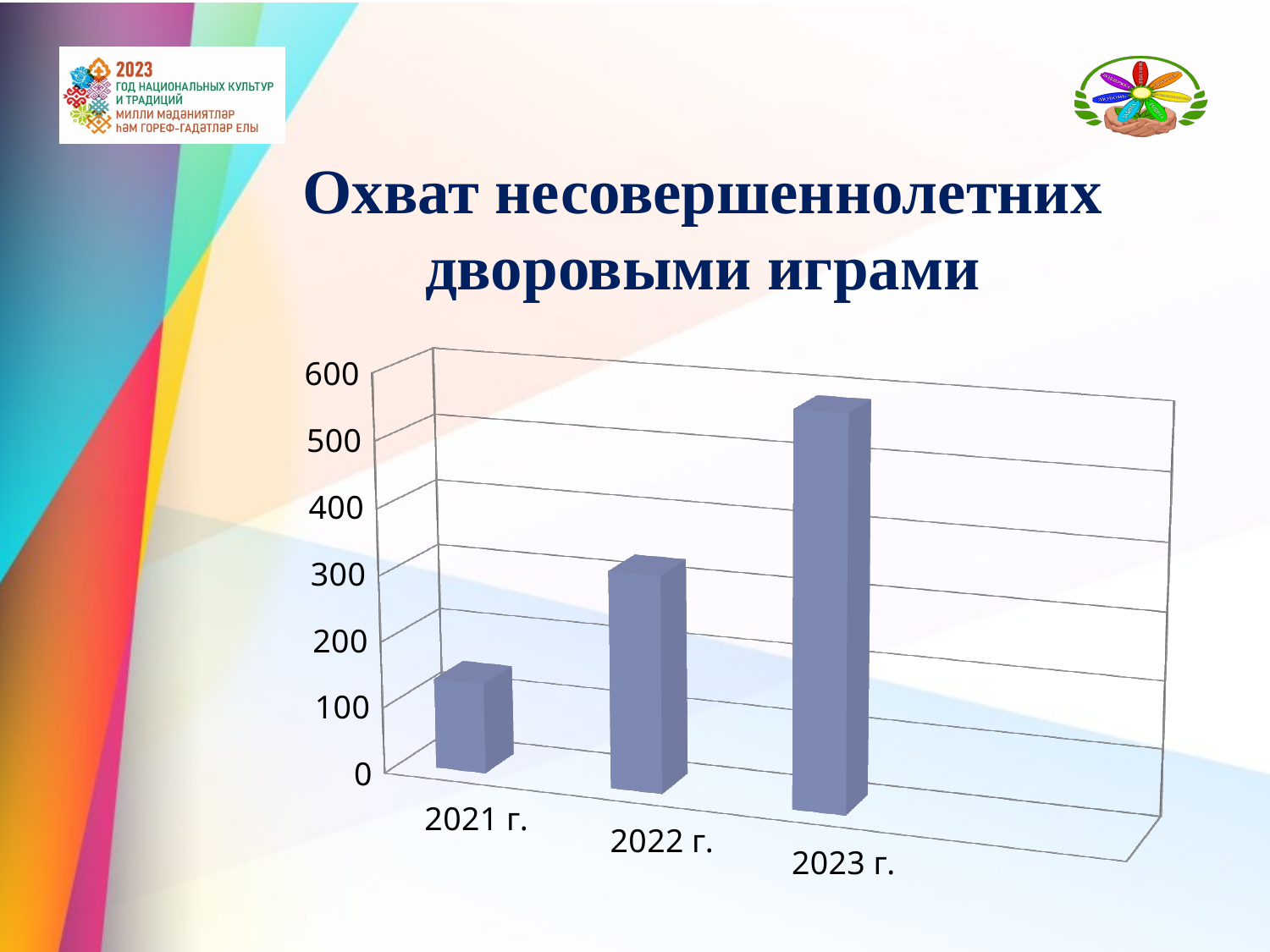
Which year has the highest value on the chart? 2023 г. Is the value for 2021 г. greater or less than 200? less Is the value for 2023 г. greater or less than 500? greater What is the title of the slide above the chart? Охват несовершеннолетних дворовыми играми Is the value for 2022 г. greater or less than 400? less Which is larger, the value for 2022 г. or the value for 2023 г.? 2023 г. What kind of chart is shown on the slide? Bar chart How many categories (years) are plotted on the chart? 3 Which year has the lowest value on the chart? 2021 г. Do the values rise or fall from 2021 г. to 2023 г.? Rise